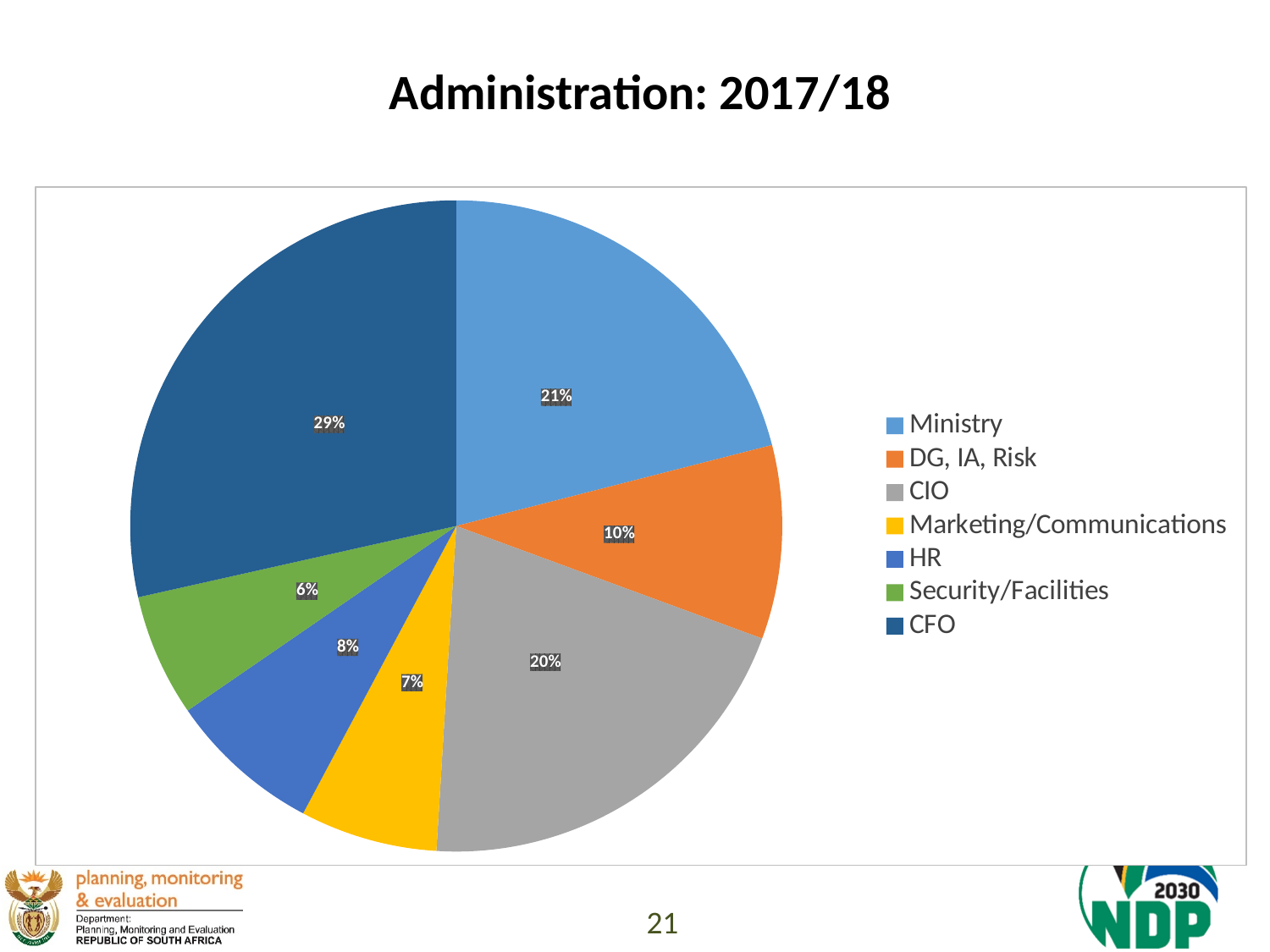
Which category has the largest slice of the pie? CFO What share of the pie does Ministry account for? 21% What share of the pie does Marketing/Communications account for? 7% Which category has the smallest slice of the pie? Security/Facilities What type of chart is shown on the slide? pie chart Which category is shown in orange in the legend? DG, IA, Risk Which is larger, the share for HR or the share for DG, IA, Risk? DG, IA, Risk What share of the pie does CFO account for? 29% How many categories does the pie chart have? 7 What is the difference between the CFO share and the Ministry share? 8% What is the title of the chart? Administration: 2017/18